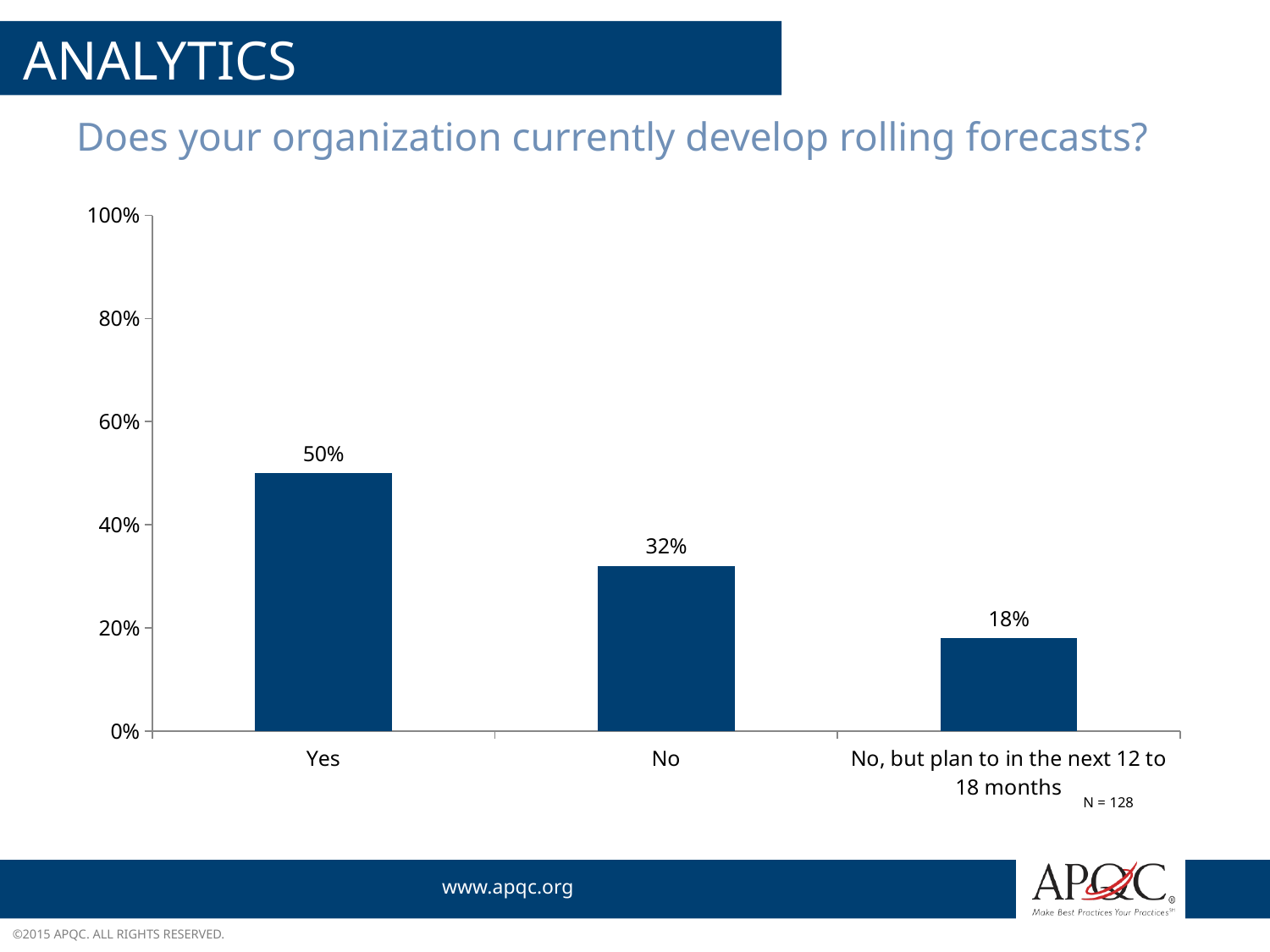
Which is larger, the percentage for "No" or the percentage for "No, but plan to in the next 12 to 18 months"? No What is the difference in percentage points between the "Yes" and "No" responses? 18 percentage points Is the value for "Yes" greater or less than 40%? greater What percentage of organizations answered "Yes" to currently developing rolling forecasts? 50% Which response category has the lowest percentage? No, but plan to in the next 12 to 18 months How many response categories are shown in the chart? 3 What percentage of organizations answered "No"? 32% Which response category has the highest percentage? Yes What is the sample size (N) noted on the chart? N = 128 What is the difference in percentage points between the "No" response and the "No, but plan to in the next 12 to 18 months" response? 14 percentage points What type of chart is shown on the slide? Bar chart What percentage of organizations answered "No, but plan to in the next 12 to 18 months"? 18%